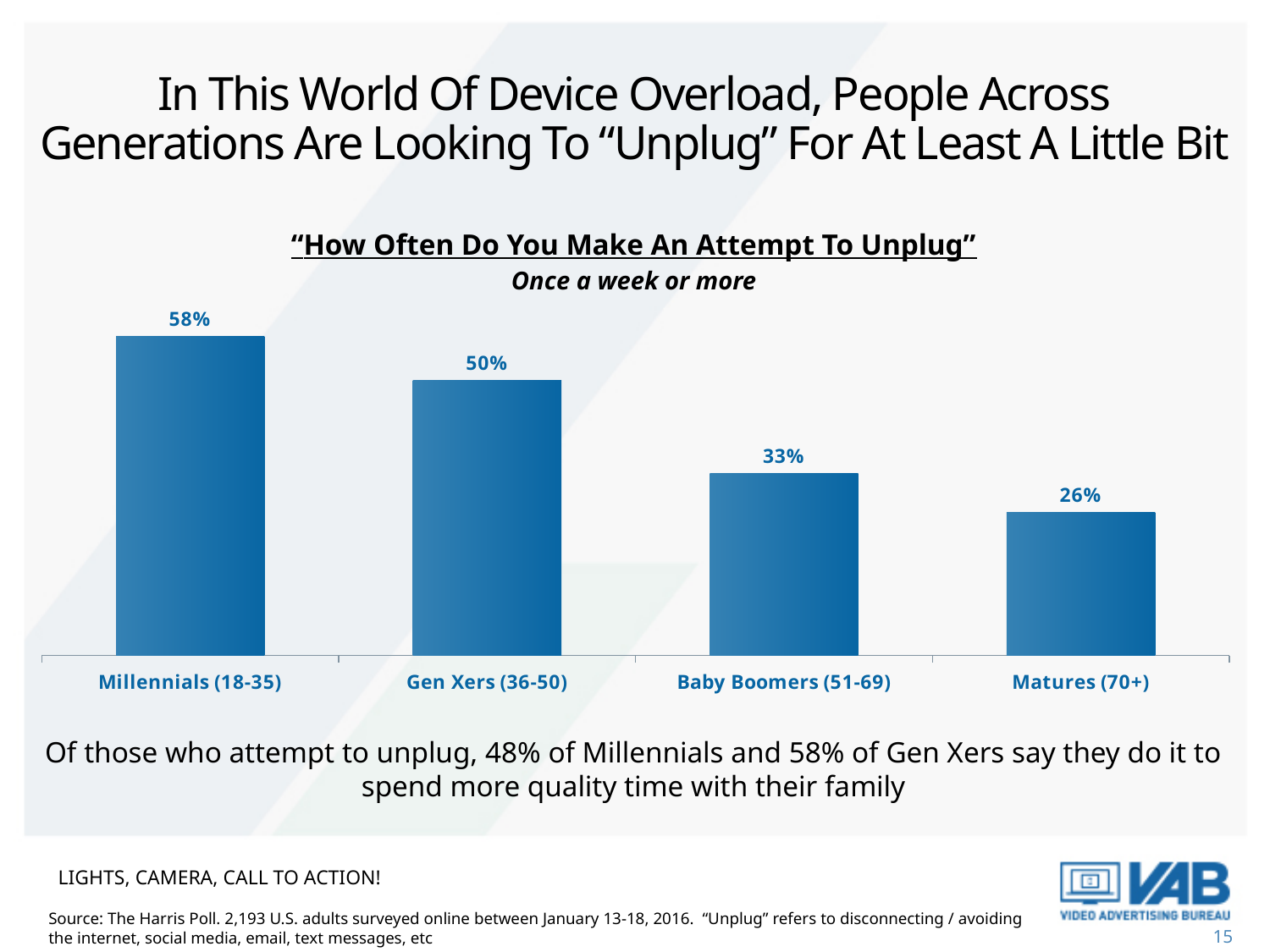
Which is larger, the value for Baby Boomers (51-69) or the value for Matures (70+)? Baby Boomers (51-69) What percentage of Millennials (18-35) attempt to unplug once a week or more? 58% Do the values rise or fall moving from Millennials to Matures along the x axis? Fall What is the value shown for Matures (70+)? 26% Which generation has the highest share attempting to unplug once a week or more? Millennials (18-35) What is the value shown for Baby Boomers (51-69)? 33% What kind of chart is shown on the slide? Bar chart What is the difference between the values for Millennials (18-35) and Matures (70+)? 32% What is the value shown for Gen Xers (36-50)? 50% What is the difference between the values for Gen Xers (36-50) and Baby Boomers (51-69)? 17% How many generation categories are shown in the chart? 4 Which generation has the lowest value in the chart? Matures (70+)